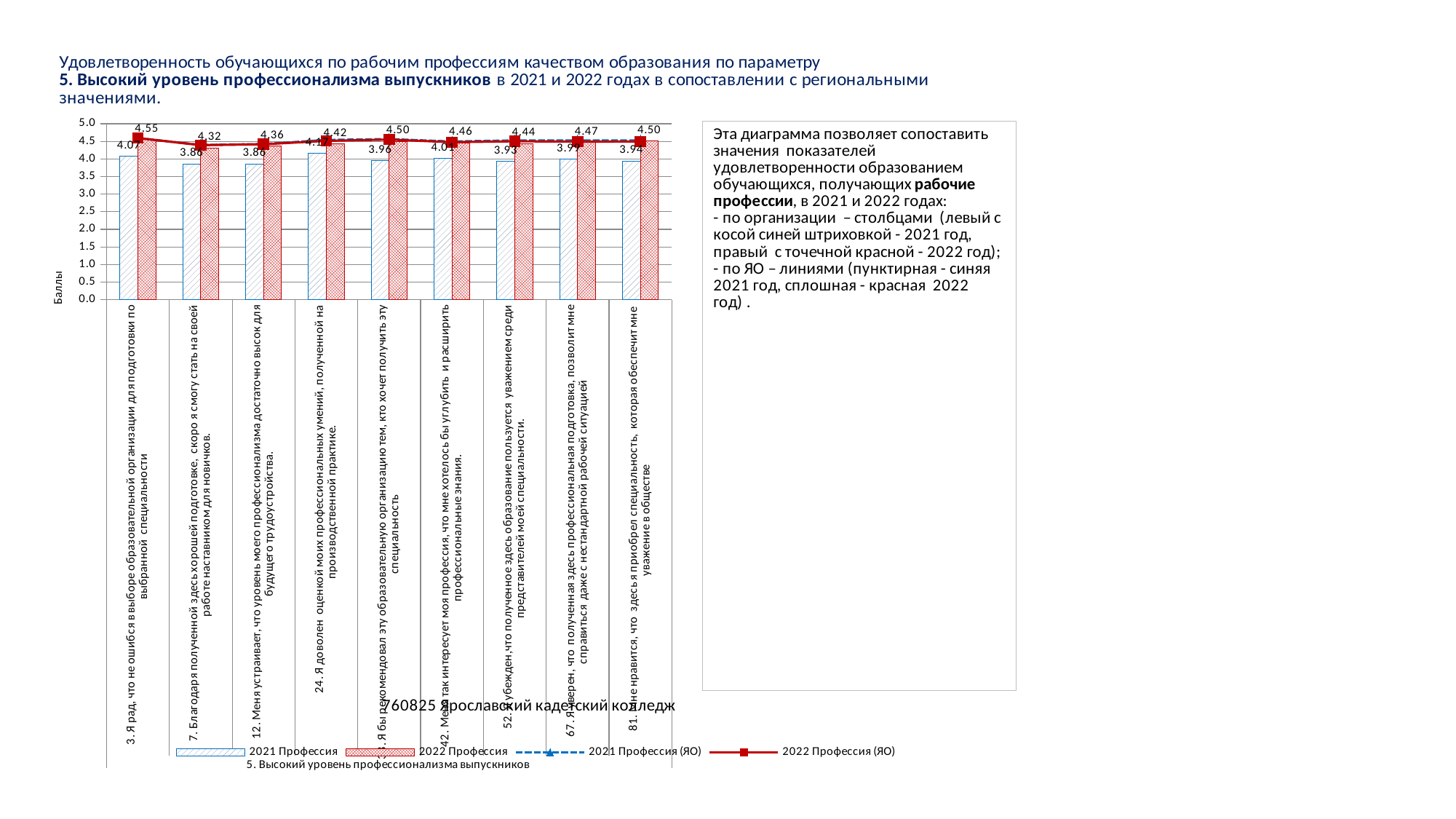
What is the 2021 Профессия value for statement 3 (Я рад, что не ошибся в выборе образовательной организации)? 4.07 How many categories (survey statements) are plotted along the x axis? 9 Is the 2021 Профессия value for statement 12 greater or less than 4.0? less What is the title of the vertical axis? Баллы How many series does the legend list? 4 What is the 2021 Профессия value for statement 52 (Я убежден, что полученное здесь образование пользуется уважением...)? 3.93 What is the 2021 Профессия value for statement 81 (Мне нравится, что здесь я приобрел специальность...)? 3.94 Which is larger for 2021 Профессия: the value for statement 3 or the value for statement 81? statement 3 (4.07) What is the 2021 Профессия value for statement 67 (Я уверен, что полученная здесь профессиональная подготовка...)? 3.99 What kind of chart is shown on the slide? bar chart (with line series) What is the difference between the 2021 Профессия values for statement 3 and statement 52? 0.14 What is the 2021 Профессия value for statement 7 (Благодаря полученной здесь хорошей подготовке...)? 3.86